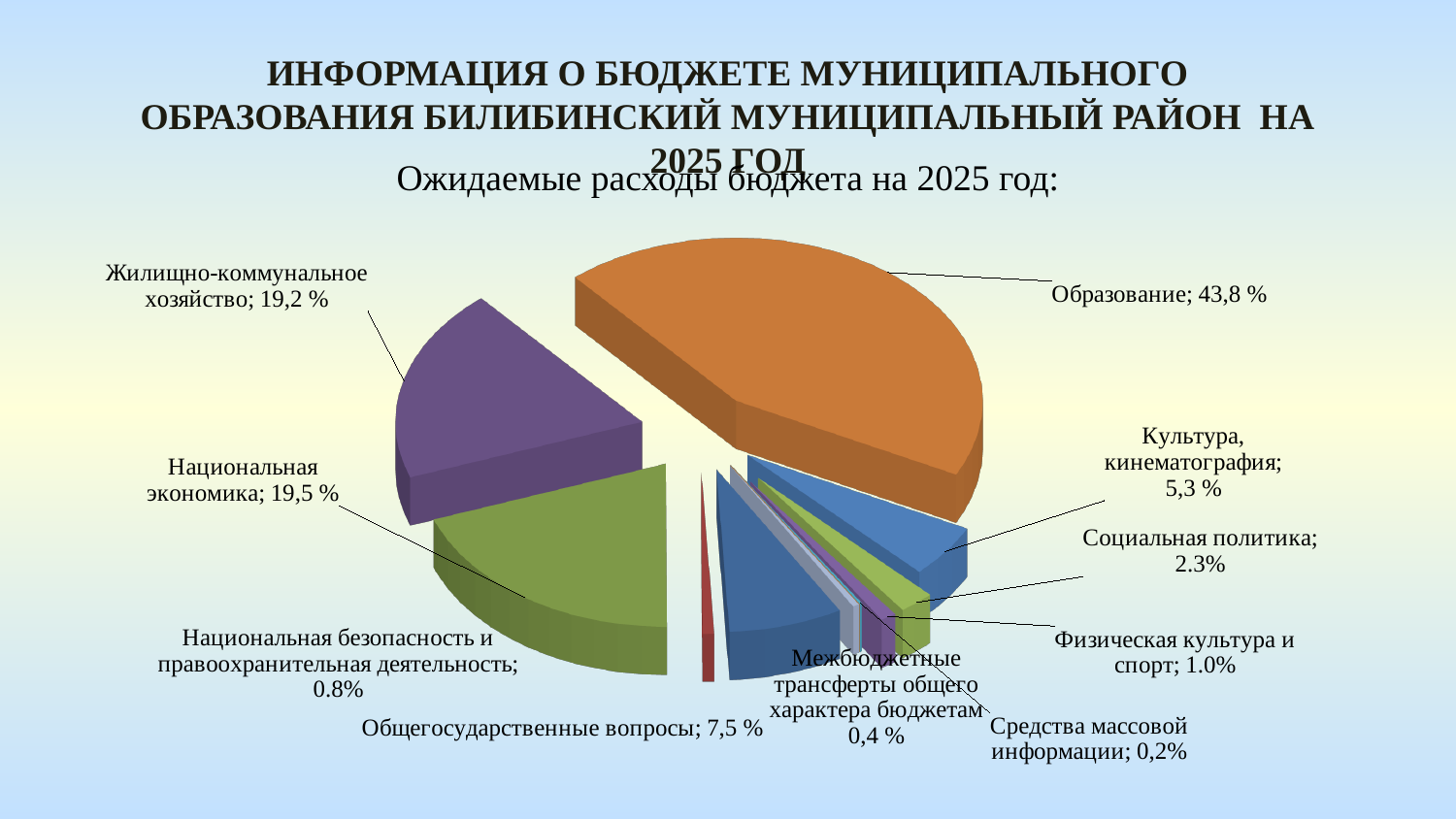
Which is larger: Национальная экономика or Жилищно-коммунальное хозяйство? Национальная экономика What share of expected 2025 budget expenditure goes to Образование? 43,8 % What is the difference in percentage points between Образование and Национальная экономика? 24,3 What is the value shown for Национальная экономика? 19,5 % How many categories are shown in the pie chart? 10 Which category has the smallest share of the pie? Средства массовой информации What is the value shown for Жилищно-коммунальное хозяйство? 19,2 % What is the value shown for Культура, кинематография? 5,3 % What kind of chart is shown on the slide? Pie chart Which category has the largest share of the pie? Образование What is the title of the chart? Ожидаемые расходы бюджета на 2025 год: What is the value shown for Общегосударственные вопросы? 7,5 %